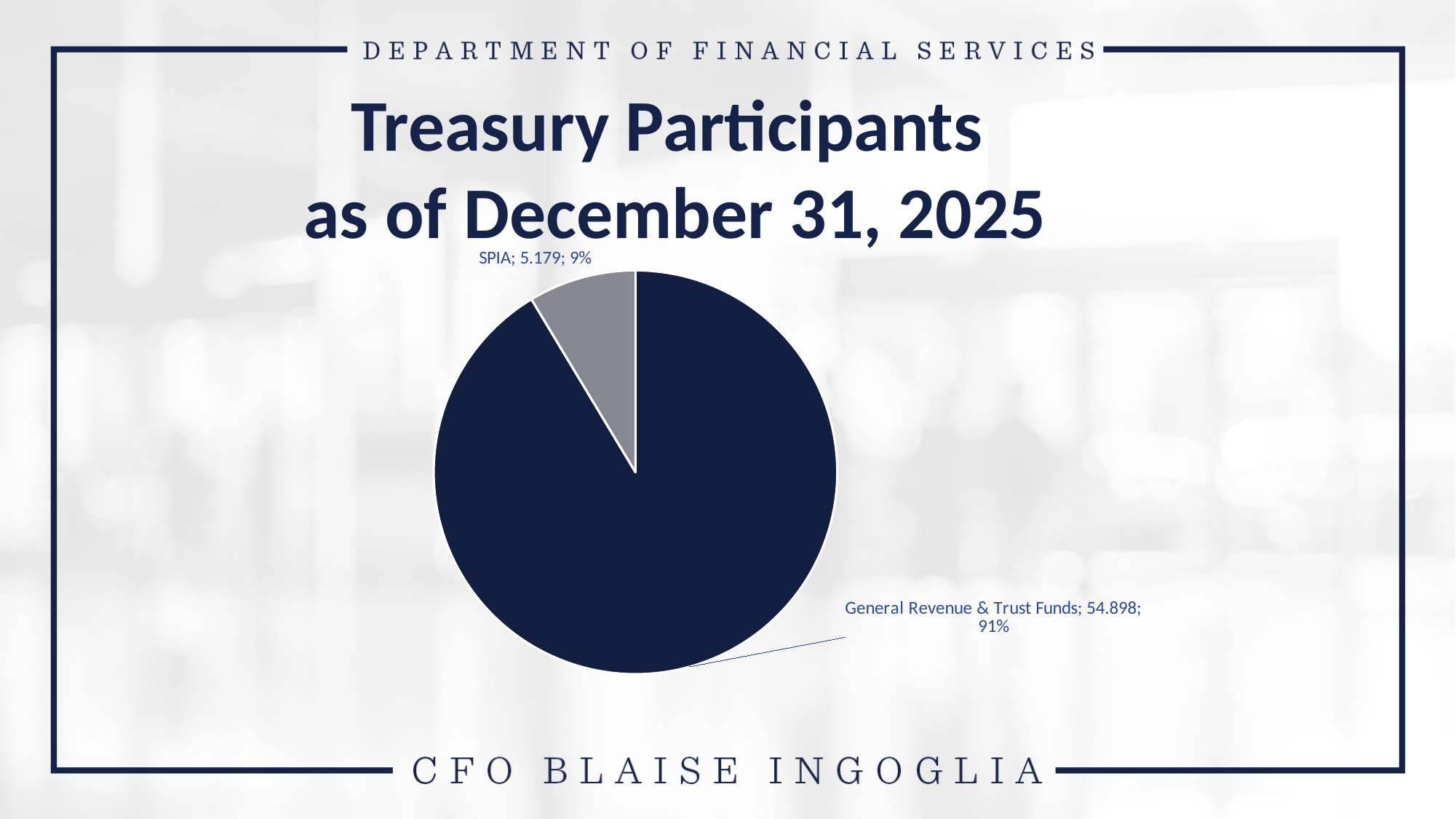
What is the difference between the value for General Revenue & Trust Funds and the value for SPIA? 49.719 What is the value for General Revenue & Trust Funds? 54.898 Which is larger, the value for SPIA or the value for General Revenue & Trust Funds? General Revenue & Trust Funds What kind of chart is shown on the slide? pie chart What share of the pie does General Revenue & Trust Funds represent? 91% Which category has the smallest slice of the pie? SPIA What is the title of the slide containing the pie chart? Treasury Participants as of December 31, 2025 Which category has the largest slice of the pie? General Revenue & Trust Funds How many slices does the pie chart have? 2 What share of the pie does SPIA represent? 9% What is the value for SPIA? 5.179 What colour is the SPIA slice of the pie? grey